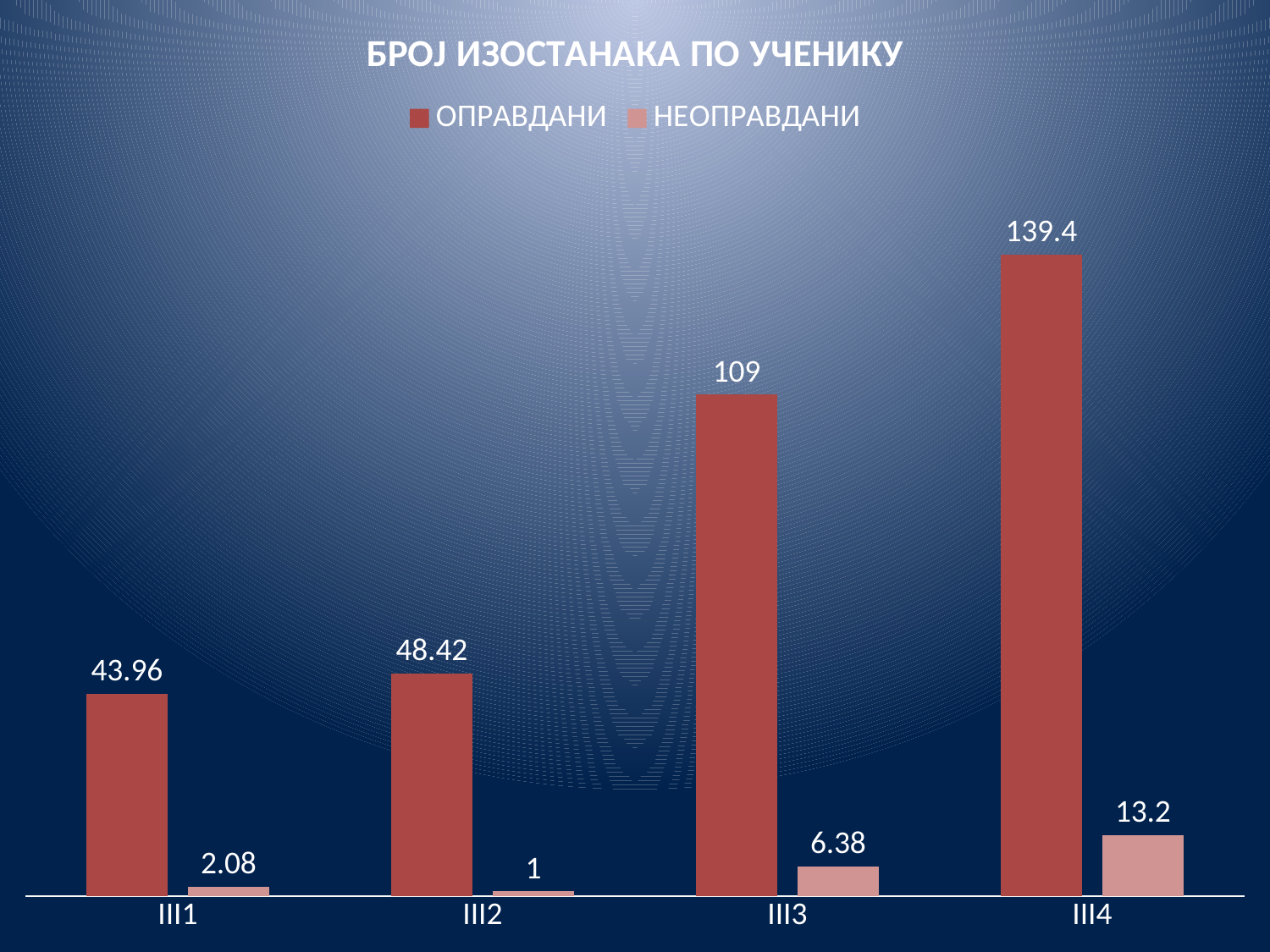
What is the ОПРАВДАНИ value for III3? 109 What is the title of the chart? БРОЈ ИЗОСТАНАКА ПО УЧЕНИКУ How many series does the legend list? 2 Which category has the highest ОПРАВДАНИ value? III4 Which category has the lowest НЕОПРАВДАНИ value? III2 What is the НЕОПРАВДАНИ value for III2? 1 What is the ОПРАВДАНИ value for III1? 43.96 What kind of chart is shown on the slide? Bar chart How many categories are shown on the x axis? 4 What is the НЕОПРАВДАНИ value for III4? 13.2 What is the difference between the ОПРАВДАНИ values for III4 and III3? 30.4 Which is larger, the ОПРАВДАНИ value for III2 or for III1? III2